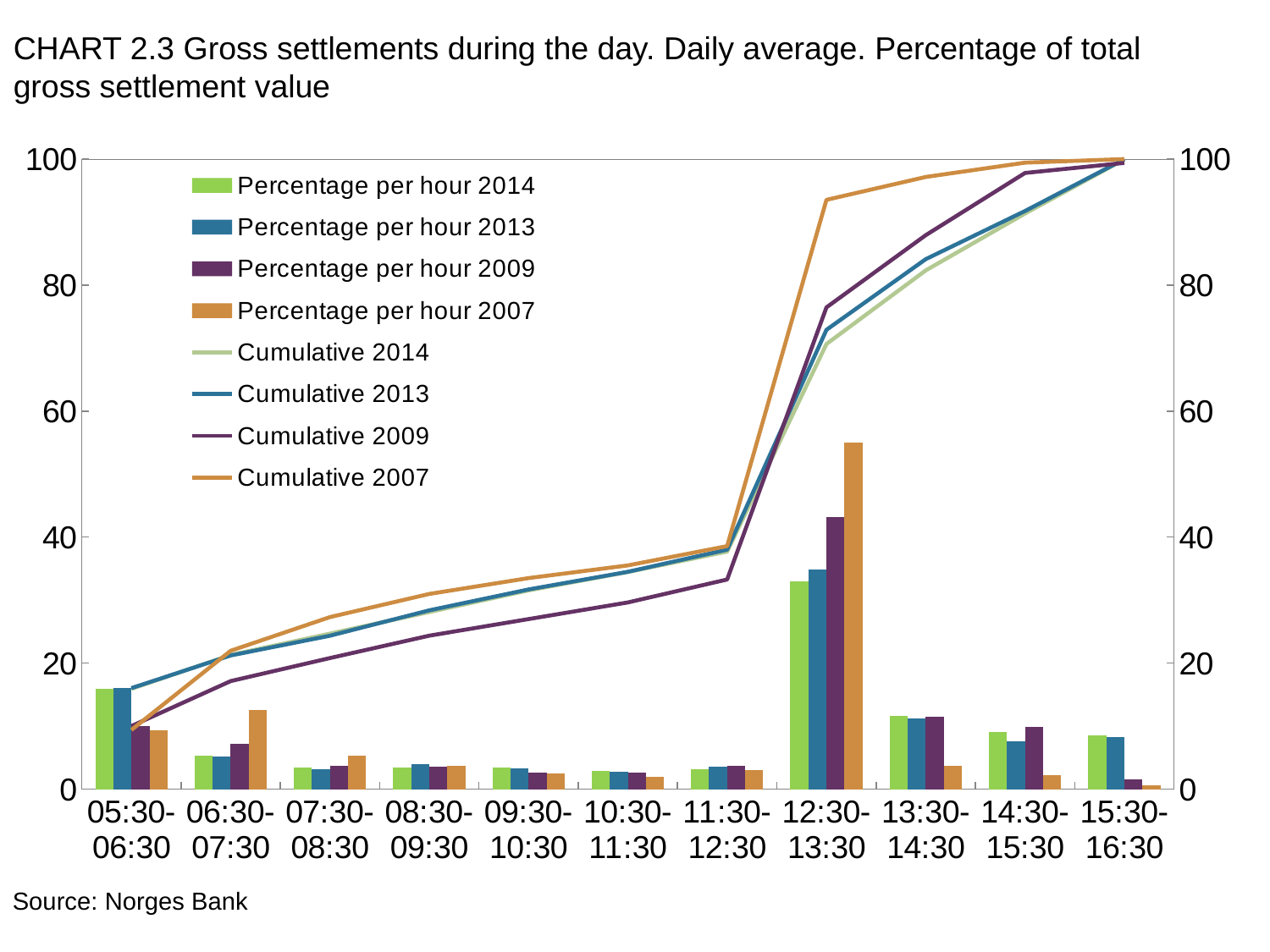
In which time interval is the Percentage per hour 2007 bar highest? 12:30-13:30 How many series does the legend list? 8 Is the Percentage per hour 2007 value for 12:30-13:30 greater or less than 40? greater Is the Percentage per hour 2014 value for 05:30-06:30 greater or less than 20? less Do the cumulative lines rise or fall across the day from 05:30-06:30 to 15:30-16:30? Rise What kind of chart is shown on the slide? A combined bar and line chart Is the Cumulative 2009 value at 11:30-12:30 greater or less than 40? less In which time interval is the Percentage per hour 2007 bar lowest? 15:30-16:30 At 14:30-15:30, which is larger: the Percentage per hour 2009 bar or the Percentage per hour 2007 bar? Percentage per hour 2009 How many time intervals are shown on the x axis? 11 At 06:30-07:30, which is larger: the Percentage per hour 2007 bar or the Percentage per hour 2014 bar? Percentage per hour 2007